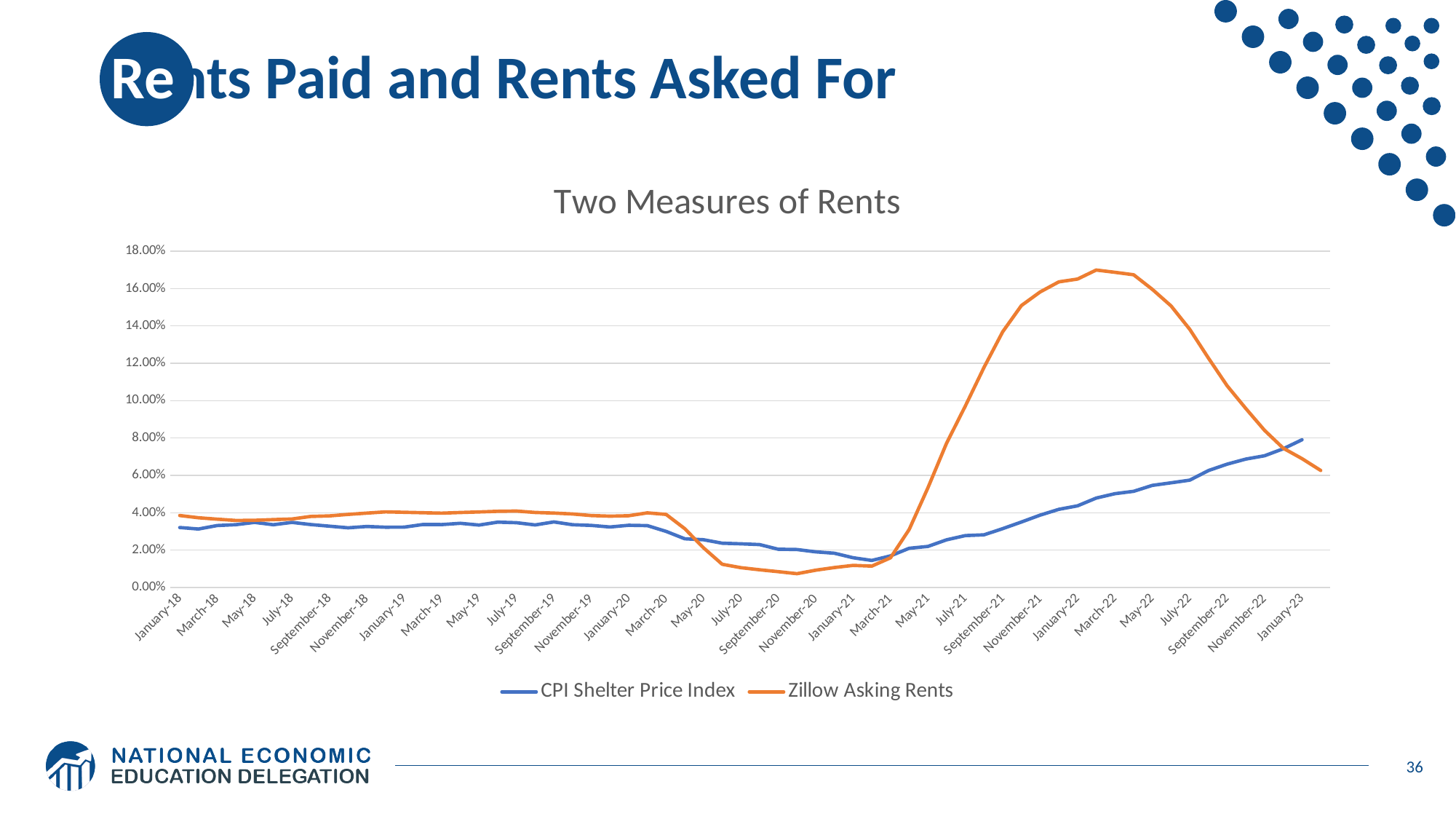
How many series does the legend list? 2 In March-22, which series has the higher value, CPI Shelter Price Index or Zillow Asking Rents? Zillow Asking Rents Is the value for CPI Shelter Price Index in January-23 greater or less than 6.00%? greater Is the value for Zillow Asking Rents in September-20 greater or less than 2.00%? less Does the CPI Shelter Price Index series rise or fall between March-21 and January-23? rise What is the title of the chart? Two Measures of Rents What kind of chart is shown on the slide? line chart In January-23, which series has the higher value, CPI Shelter Price Index or Zillow Asking Rents? CPI Shelter Price Index Is the value for Zillow Asking Rents in March-22 greater or less than 16.00%? greater What are the two series named in the legend? CPI Shelter Price Index and Zillow Asking Rents